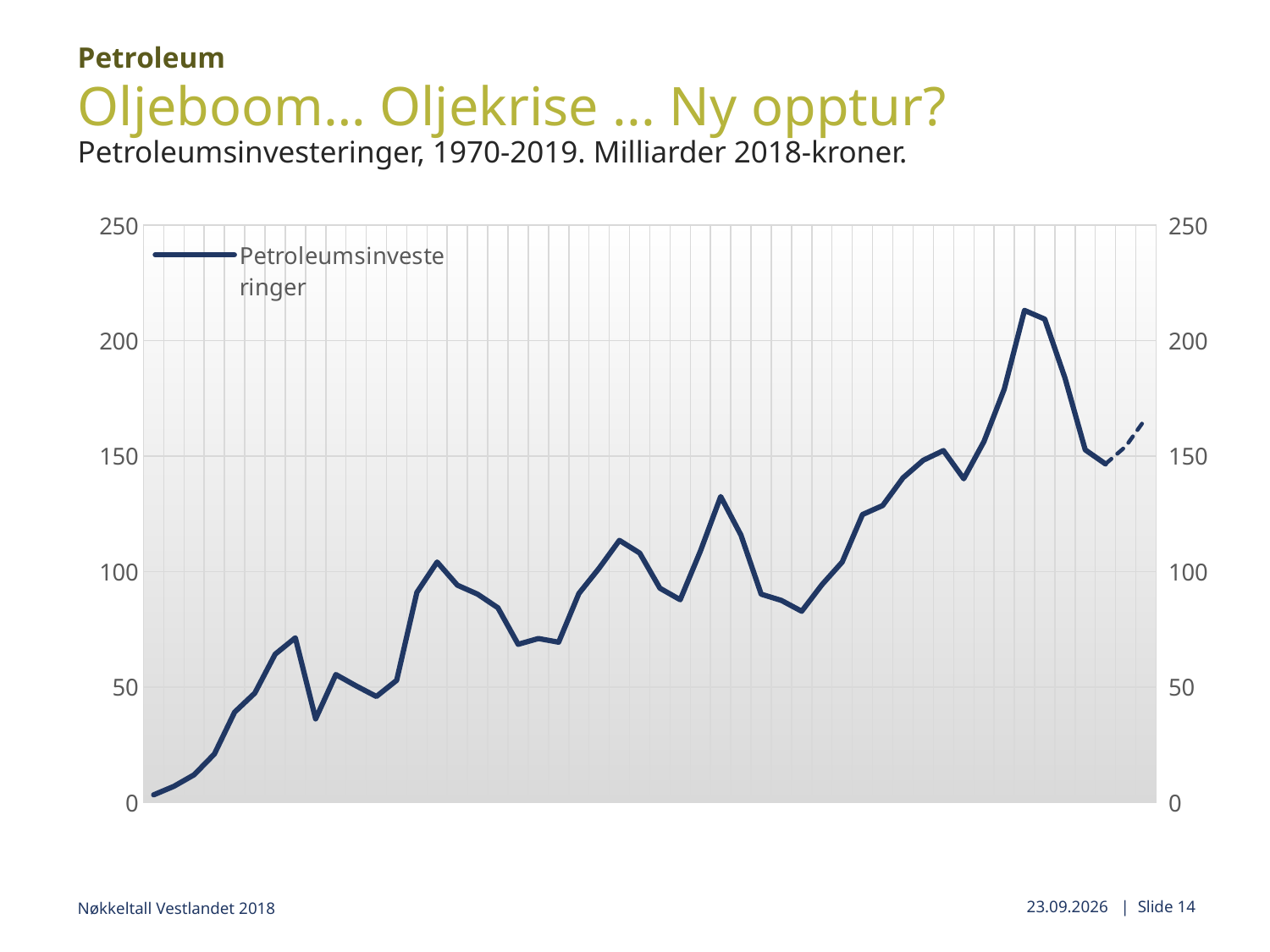
Is the highest point of the line greater or less than 200? greater What kind of chart is shown on the slide? line chart Overall, do the values rise or fall from the left to the right of the chart? rise Is the lowest point of the line greater or less than 50? less Is the first point of the line greater or less than 50? less What is the name of the series shown in the legend? Petroleumsinvesteringer How many series does the legend list? 1 What is the subtitle describing the chart's data? Petroleumsinvesteringer, 1970-2019. Milliarder 2018-kroner.